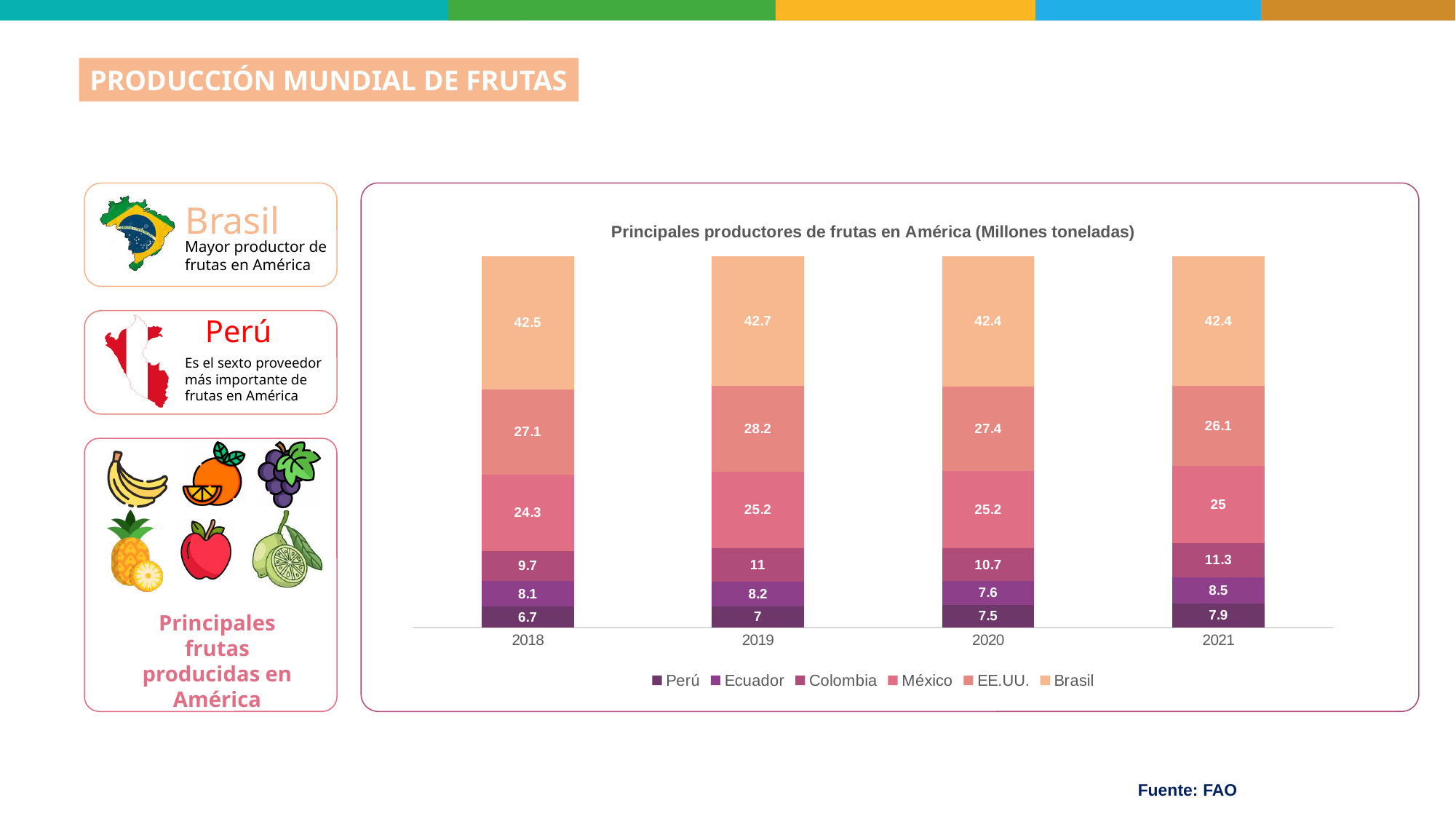
What is the difference between EE.UU. and México in 2021? 1.1 Which country had the lowest fruit production in 2018? Perú What is the total of the stacked bar for 2019? 122.3 Did Perú's production rise or fall from 2018 to 2021? Rise Which was larger in 2020, Colombia or Ecuador? Colombia What was México's fruit production in 2018? 24.3 How many series does the legend list? 6 What was Brasil's fruit production in 2019? 42.7 What type of chart is shown on the slide? Stacked bar chart How many years are shown on the x axis? 4 Which country had the highest fruit production in 2020? Brasil What was Perú's fruit production in 2021? 7.9